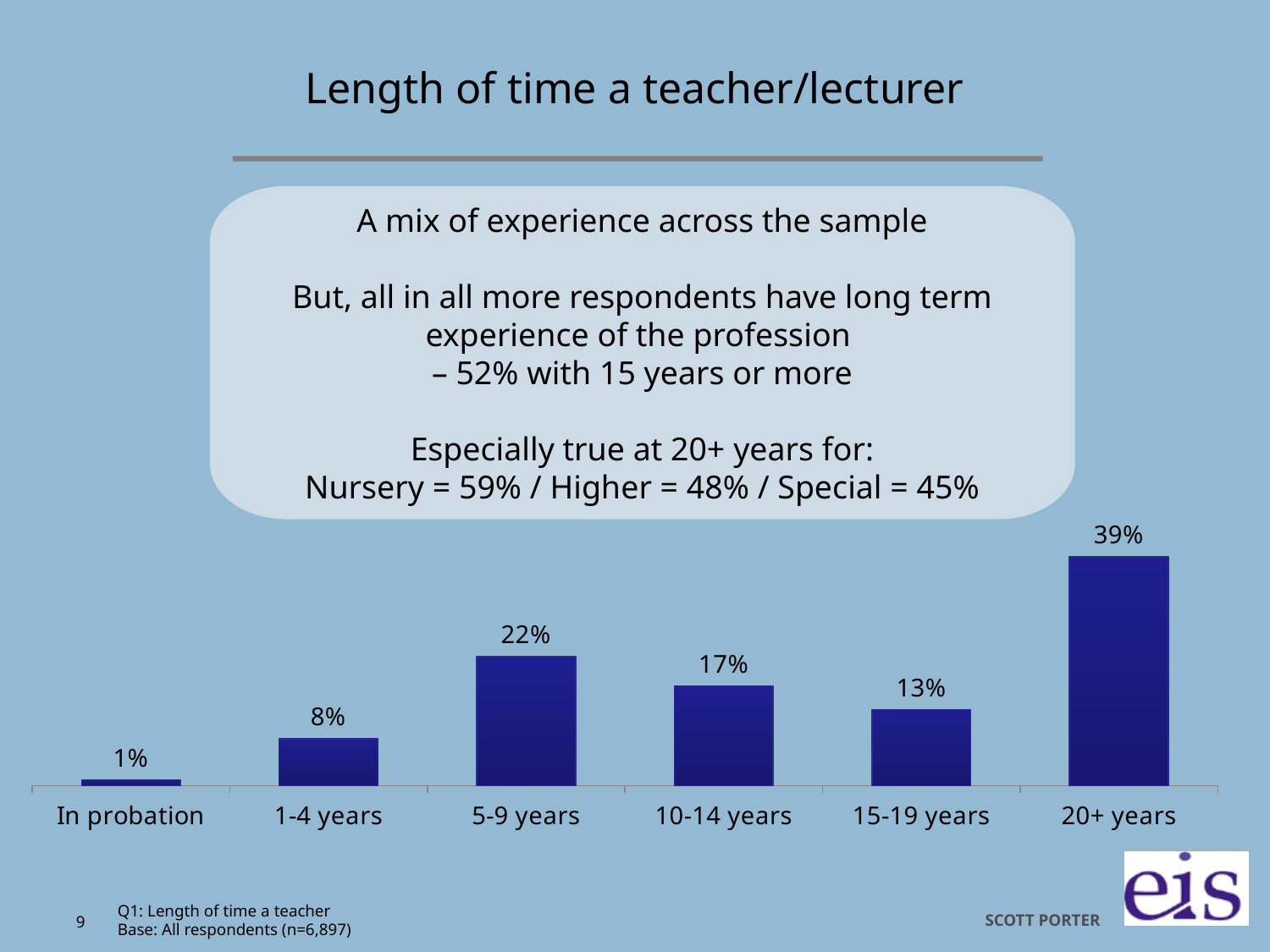
What is the combined value of the 15-19 years and 20+ years categories? 52% How many categories are shown on the x axis of the chart? 6 Which is larger, the value for 10-14 years or the value for 15-19 years? 10-14 years What kind of chart is shown on the slide? Bar chart What percentage of respondents are in probation? 1% What is the difference between the 20+ years and 5-9 years values? 17 percentage points Which category has the lowest percentage of respondents? In probation What percentage of respondents have been a teacher/lecturer for 20+ years? 39% What is the value for the 5-9 years category? 22% What is the difference between the 10-14 years and 1-4 years values? 9 percentage points What is the value for the 15-19 years category? 13% Which category has the highest percentage of respondents? 20+ years